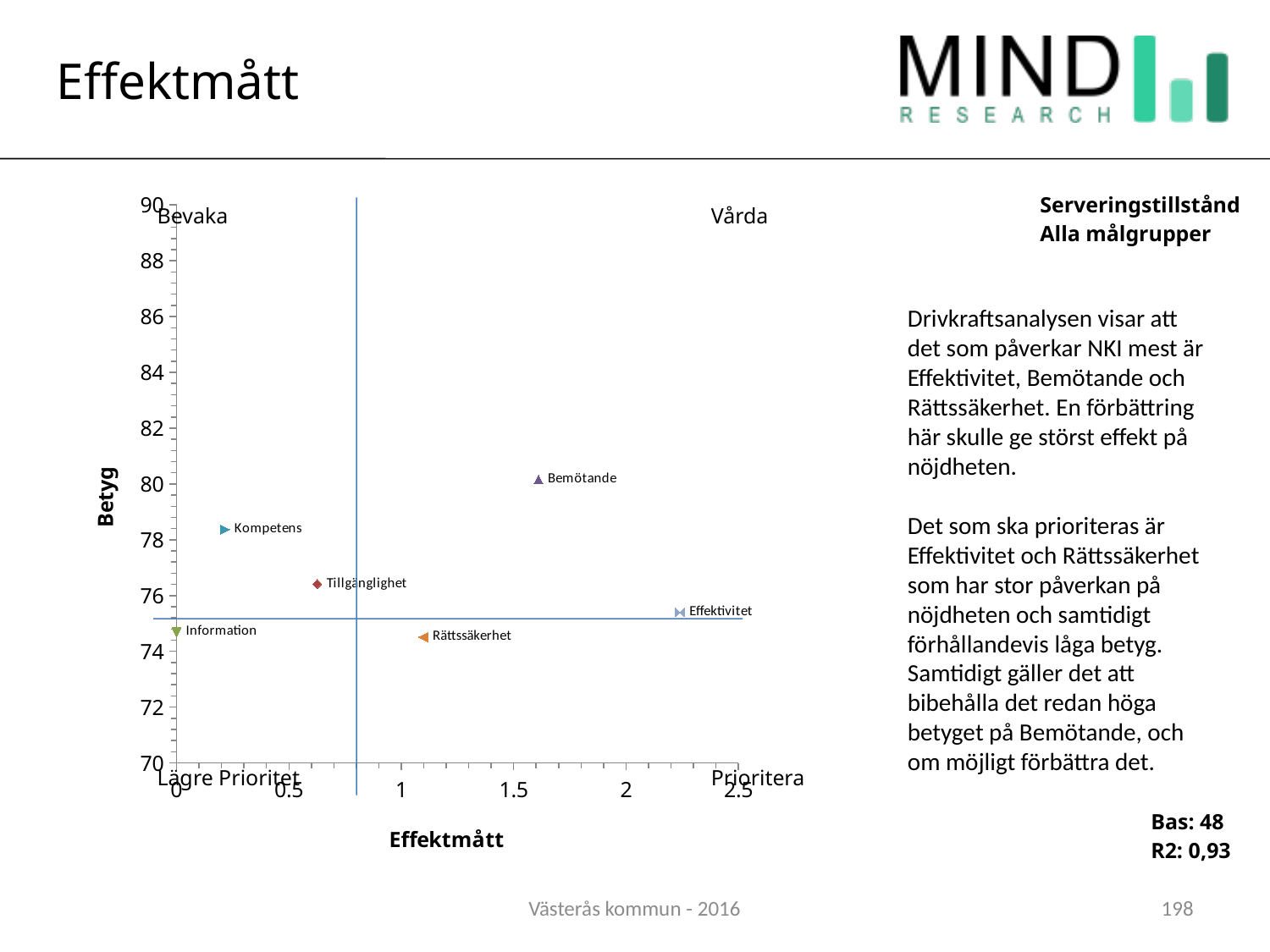
Is the Effektmått value for Information greater or less than 0.5? less What is the title of the vertical axis of the chart? Betyg Is the Betyg value for Bemötande greater or less than 78? greater What kind of chart is shown on the slide? Scatter chart Which point has the highest Effektmått value? Effektivitet Is the Betyg value for Rättssäkerhet greater or less than 76? less Which has a higher Betyg value, Bemötande or Kompetens? Bemötande Which point has the highest Betyg value? Bemötande Which point has the lowest Effektmått value? Information Which has a higher Effektmått value, Effektivitet or Tillgänglighet? Effektivitet How many data points are plotted in the chart? 6